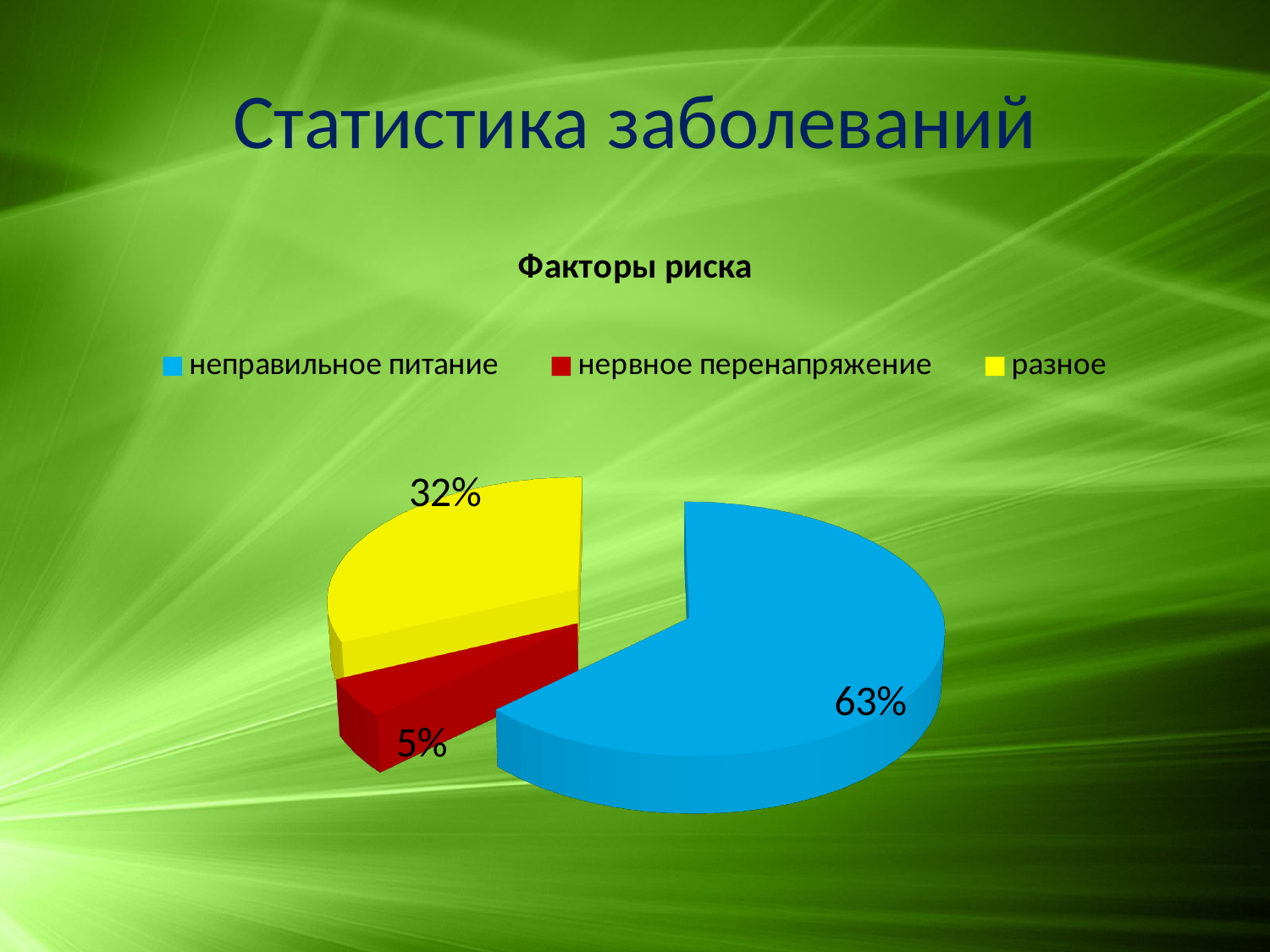
What type of chart is shown on the slide? pie chart How many entries does the legend list? 3 How many categories does the pie chart show? 3 Which is larger, the share of 'разное' or the share of 'нервное перенапряжение'? разное What is the difference between the shares of 'неправильное питание' and 'разное'? 31% Which category has the smallest slice of the pie? нервное перенапряжение What share of the pie does 'разное' have? 32% What share of the pie does 'нервное перенапряжение' have? 5% Which category has the largest slice of the pie? неправильное питание What is the title of the chart? Факторы риска What share of the pie does 'неправильное питание' have? 63% What colour is the slice for 'разное'? yellow